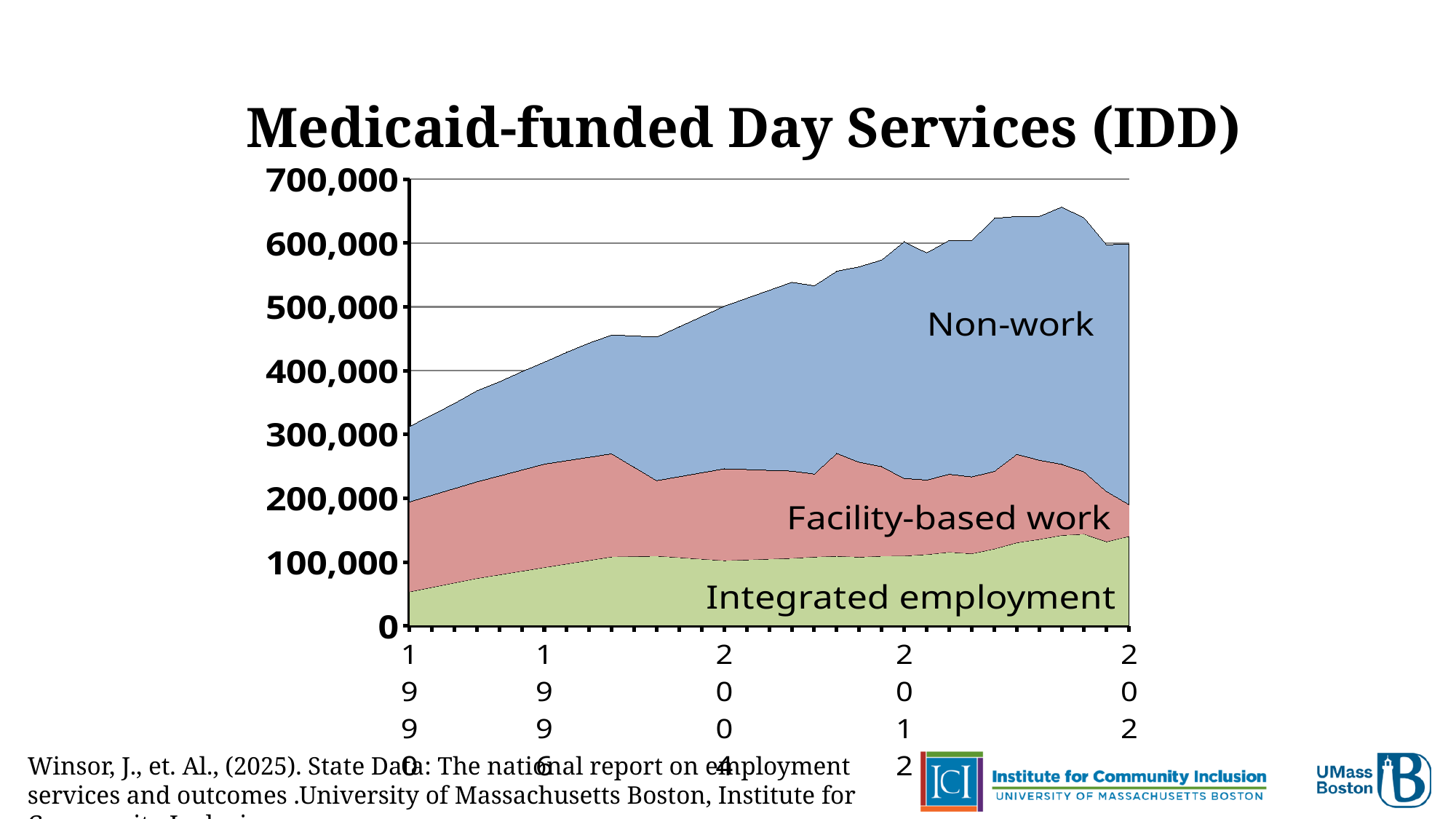
Does the total of all three series generally rise or fall from 1990 to 2022? rise How many series are plotted in the chart? 3 Is the value for Integrated employment in 2022 greater or less than 100,000? greater What is the title of the chart? Medicaid-funded Day Services (IDD) Is the total value for 1990 greater or less than 400,000? less Is the value for Integrated employment in 1990 greater or less than 100,000? less Does the Integrated employment series generally rise or fall from 1990 to 2022? rise What kind of chart is shown on the slide? Stacked area chart How many year labels are shown on the x axis? 5 Which series is plotted at the top of the stacked areas? Non-work